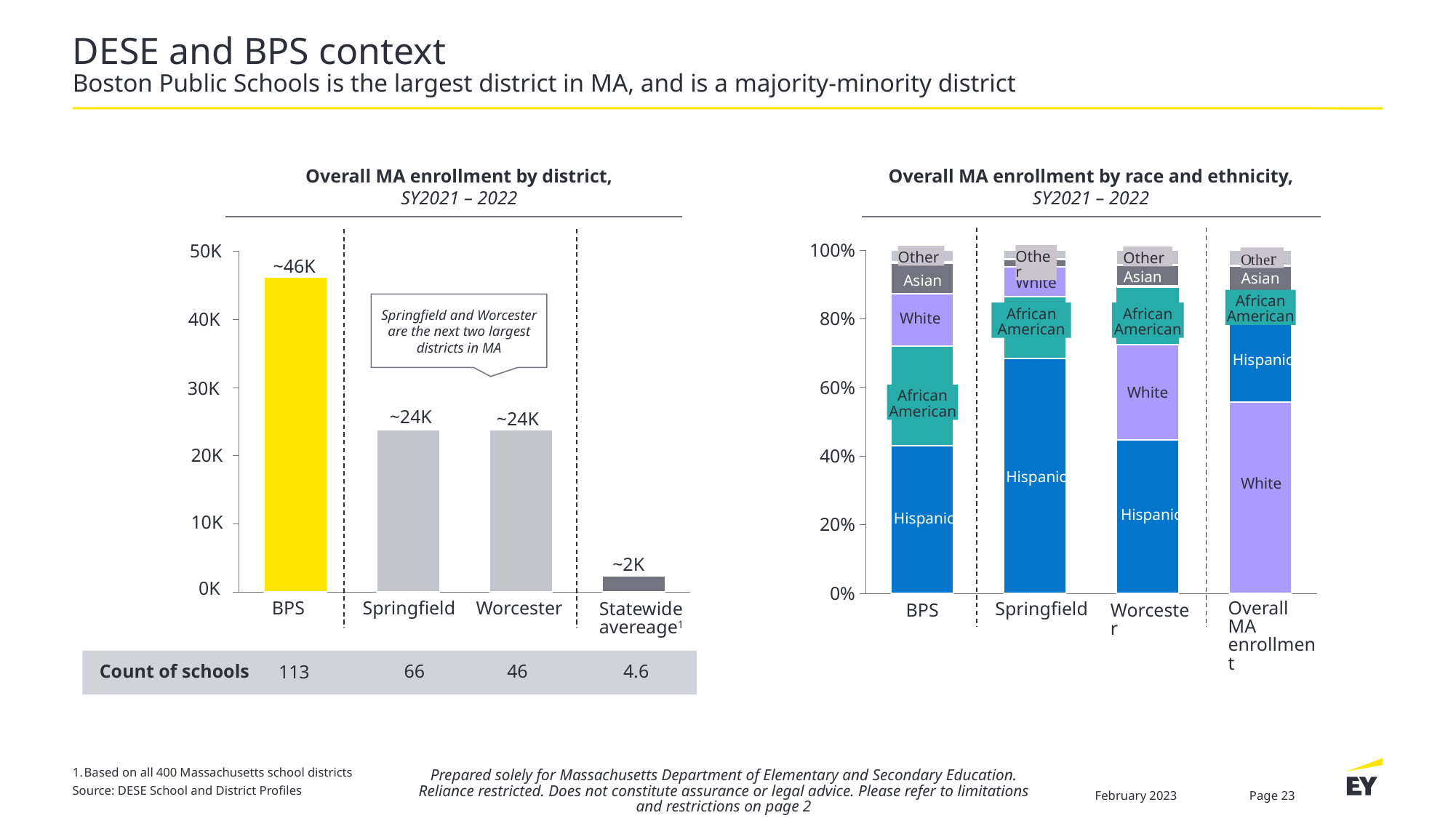
In the 'Overall MA enrollment by race and ethnicity' chart, is the Hispanic share for Springfield greater or less than 60%? greater In the 'Overall MA enrollment by district' chart, what is the count of schools for Springfield? 66 In the 'Overall MA enrollment by race and ethnicity' chart, is the White share for Overall MA enrollment greater or less than 40%? greater In the 'Overall MA enrollment by district' chart, which is larger, the enrollment for BPS or for Worcester? BPS What kind of chart is the 'Overall MA enrollment by district' chart on the left? bar chart In the 'Overall MA enrollment by district' chart, is the value for Springfield greater or less than 30K? less In the 'Overall MA enrollment by district' chart, what is the count of schools for BPS? 113 In the 'Overall MA enrollment by district' chart, which district has the highest enrollment? BPS In the 'Overall MA enrollment by district' chart, which category has the lowest value? Statewide avereage How many bars are shown in the 'Overall MA enrollment by district' chart? 4 How many stacked bars are shown in the 'Overall MA enrollment by race and ethnicity' chart? 4